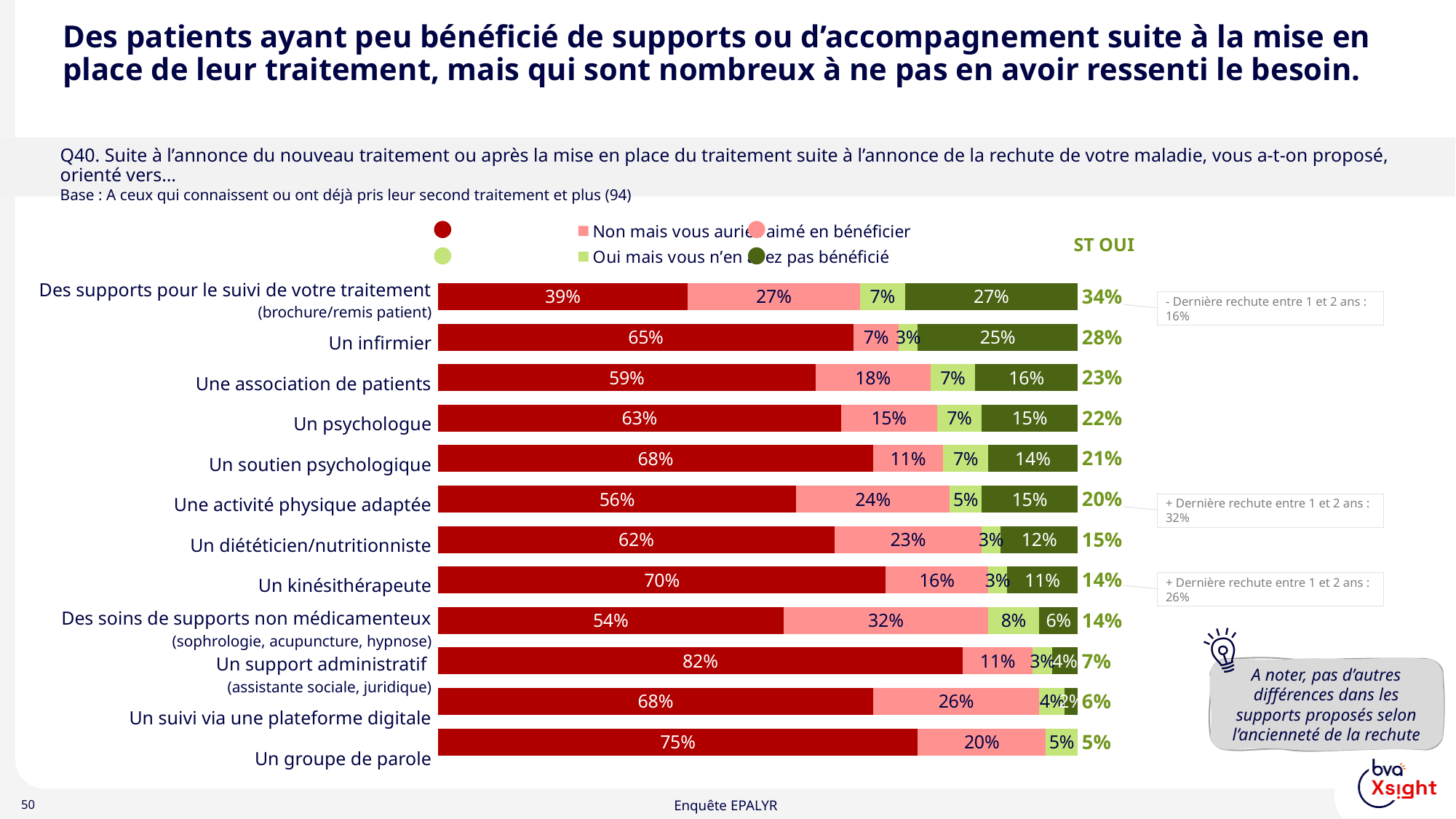
Which category has the lowest ST OUI value? Un groupe de parole Which category has the highest ST OUI value? Des supports pour le suivi de votre traitement What is the ST OUI value for "Une association de patients"? 23% Which category has the highest dark red segment value? Un support administratif What is the value of the pink segment ("Non mais vous auriez aimé en bénéficier") for "Des supports pour le suivi de votre traitement"? 27% Which has a larger dark red segment value: "Un infirmier" or "Un groupe de parole"? Un groupe de parole How many categories (types of support) are listed on the chart? 12 What colour represents the legend entry "Non mais vous auriez aimé en bénéficier"? Pink What is the difference between the dark red segment values for "Un kinésithérapeute" and "Un psychologue"? 7 percentage points What is the value of the dark red segment for "Un infirmier"? 65% What is the total of the stacked bar for "Un psychologue"? 100% What kind of chart is shown on the slide? Stacked bar chart